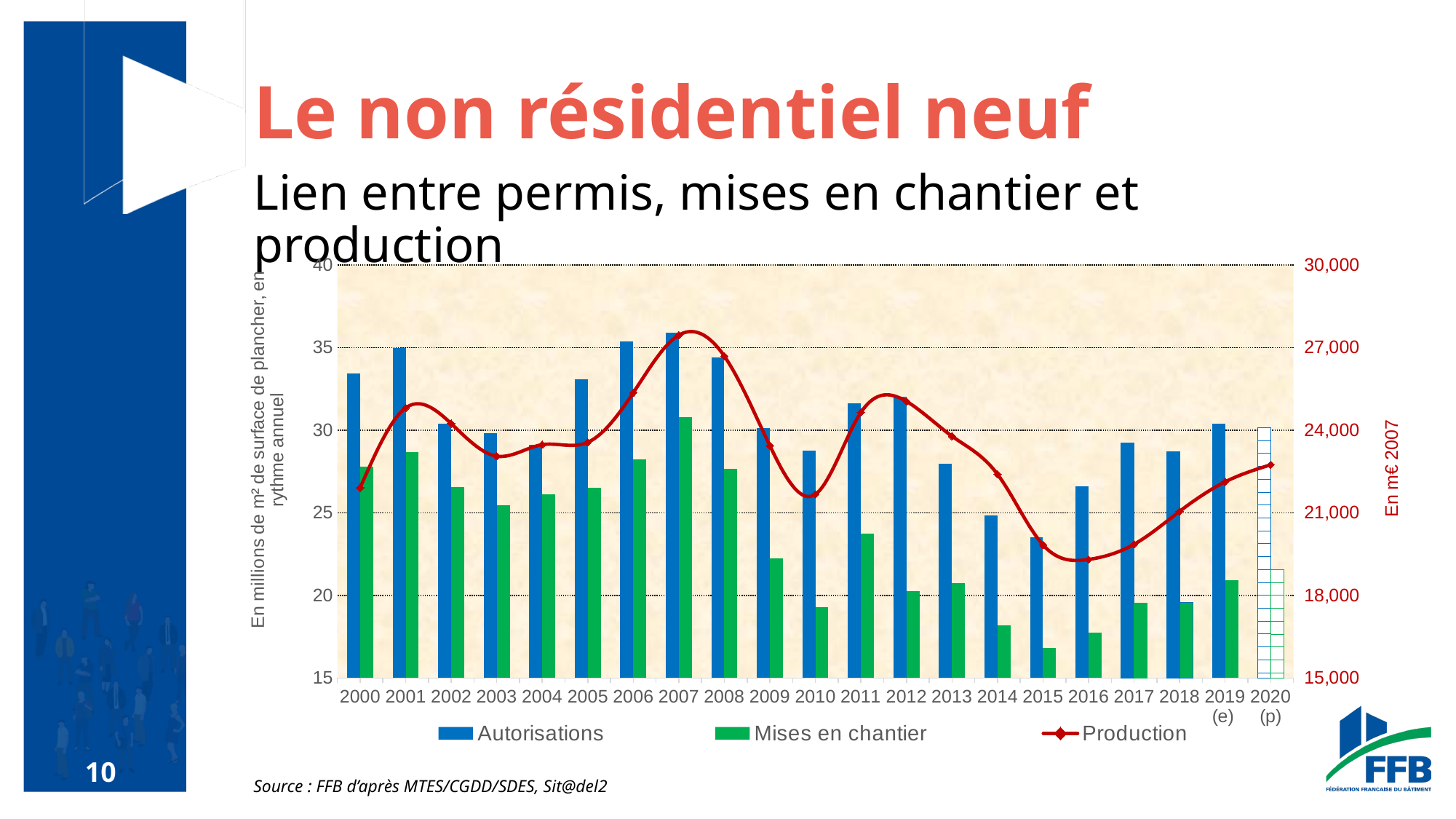
Is the value for Mises en chantier in 2007 greater or less than 30? greater What kind of chart is shown on the slide? A combined bar and line chart Is the value for Production in 2010 greater or less than 24,000? less Which year has the lowest value for Mises en chantier? 2015 How many years are shown along the x axis? 21 Is the value for Autorisations in 2015 greater or less than 25? less Which year has the highest value for Production? 2007 Do the values for Mises en chantier rise or fall from 2007 to 2010? fall Which year has the highest value for Mises en chantier? 2007 Which year has the lowest value for Autorisations? 2015 How many series does the legend list? 3 Which is larger, Autorisations in 2001 or Autorisations in 2015? 2001